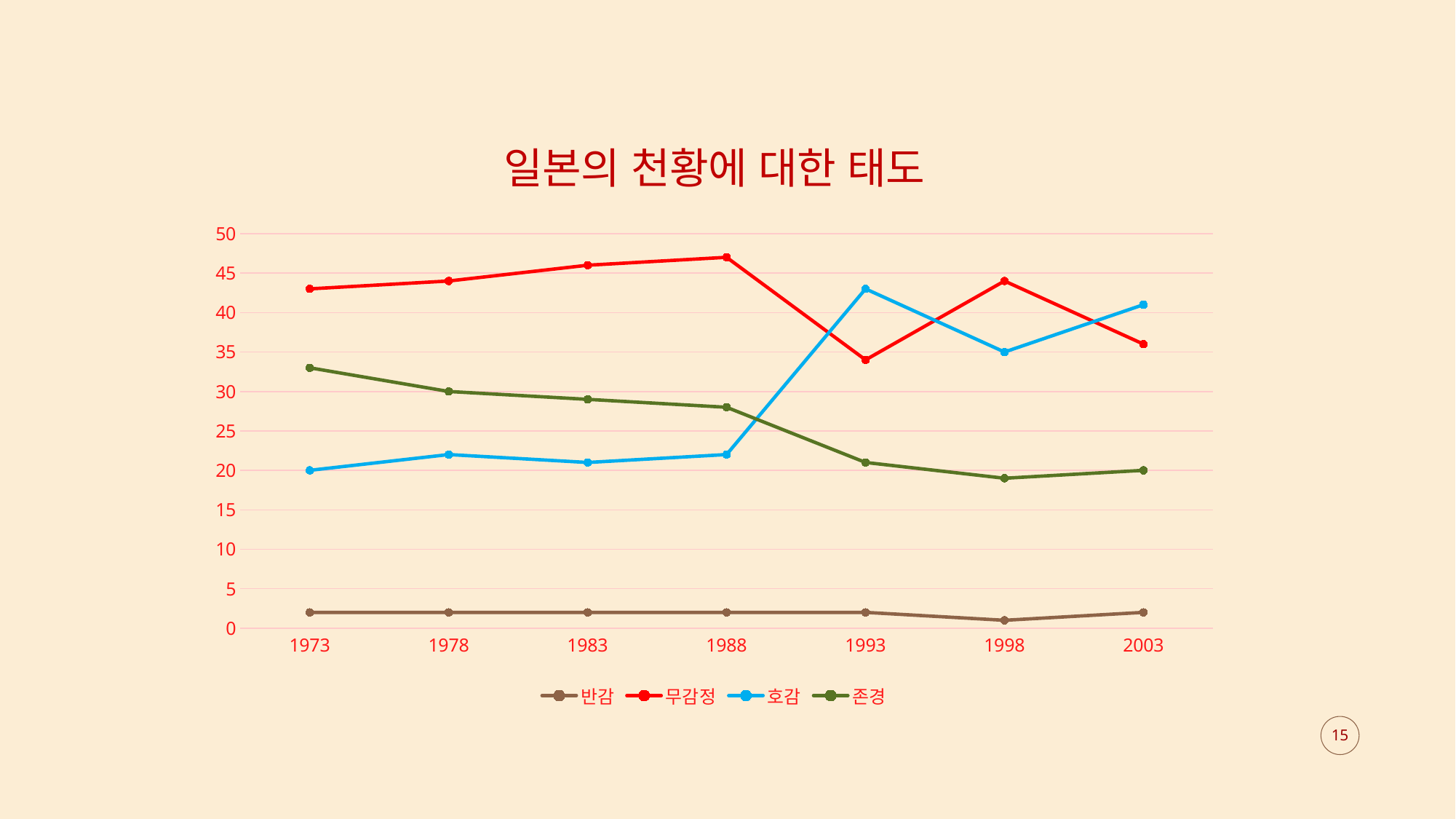
Which series has the highest value in 1973? 무감정 How many series does the legend list? 4 What is the value for 호감 in 1998? 35 Does the 존경 series rise or fall from 1973 to 2003? fall What is the value for 존경 in 1978? 30 What is the value for 호감 in 1973? 20 Is the value for 존경 in 1998 greater or less than 20? less Is the value for 무감정 in 1988 greater or less than 45? greater How many years are plotted along the x axis? 7 In 1993, which is larger, 호감 or 무감정? 호감 Is the value for 반감 in 1983 greater or less than 5? less What kind of chart is shown on the slide? line chart